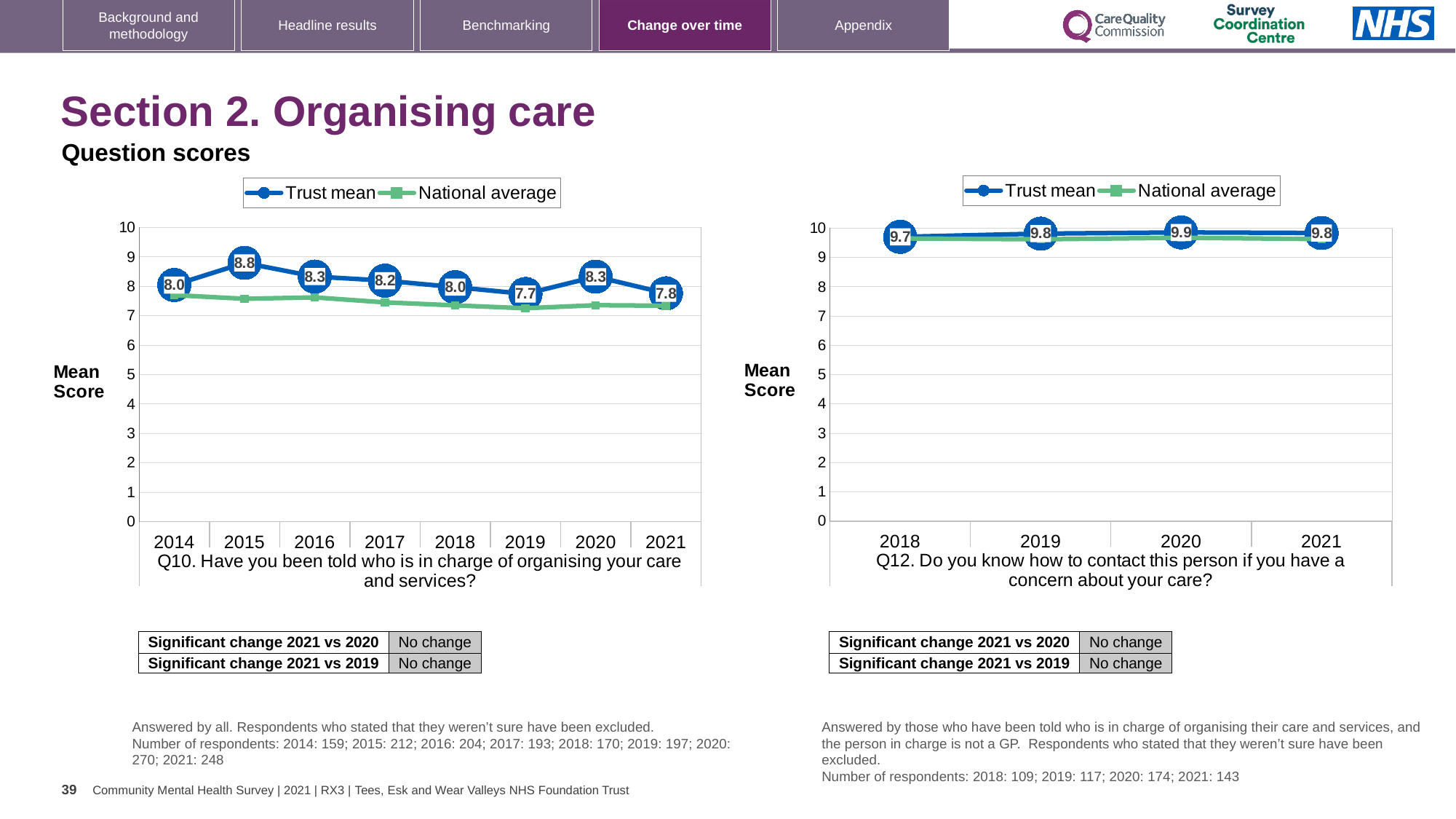
In the Q10 chart on the left, what is the Trust mean for 2021? 7.8 In the Q10 chart on the left, which year has the lowest Trust mean? 2019 In the Q10 chart on the left, what is the difference between the Trust mean in 2015 and in 2019? 1.1 In the Q10 chart on the left, which year has the highest Trust mean? 2015 What type of chart is the Q12 chart on the right? Line chart In the Q12 chart on the right, what is the difference between the Trust mean in 2020 and in 2018? 0.2 In the Q12 chart on the right, what is the Trust mean for 2020? 9.9 How many series does the legend of the Q12 chart on the right list? 2 How many years are shown on the x axis of the Q10 chart on the left? 8 In the Q10 chart on the left, is the National average for 2019 greater or less than 8? less In the Q10 chart on the left, what is the Trust mean for 2015? 8.8 In the Q10 chart on the left, is the Trust mean higher in 2020 or in 2021? 2020